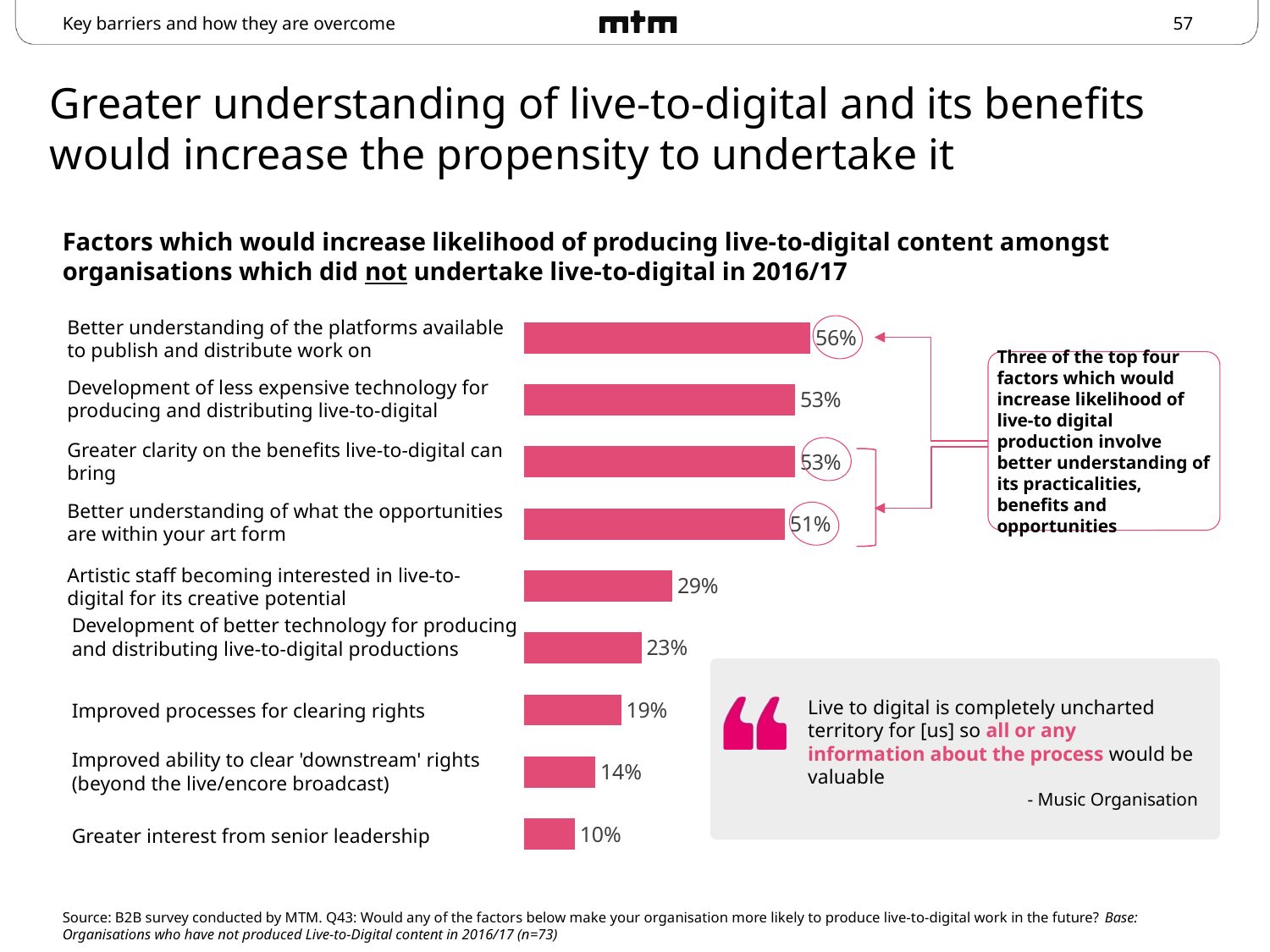
What is the sample size (n) stated in the base note for the chart? n=73 How many factors are shown in the chart? 9 Which factor has the highest percentage in the chart? Better understanding of the platforms available to publish and distribute work on What type of chart is used on this slide? Bar chart Which has a higher value: 'Improved ability to clear 'downstream' rights' or 'Improved processes for clearing rights'? Improved processes for clearing rights What is the value for 'Greater interest from senior leadership'? 10% What is the value for 'Improved processes for clearing rights'? 19% What is the difference between the highest and lowest values in the chart? 46 percentage points Which factor has the lowest percentage in the chart? Greater interest from senior leadership What is the value for 'Better understanding of what the opportunities are within your art form'? 51% What percentage of organisations said better understanding of the platforms available to publish and distribute work on would increase their likelihood of producing live-to-digital content? 56% What is the difference in percentage points between 'Artistic staff becoming interested in live-to-digital for its creative potential' and 'Development of better technology for producing and distributing live-to-digital productions'? 6 percentage points